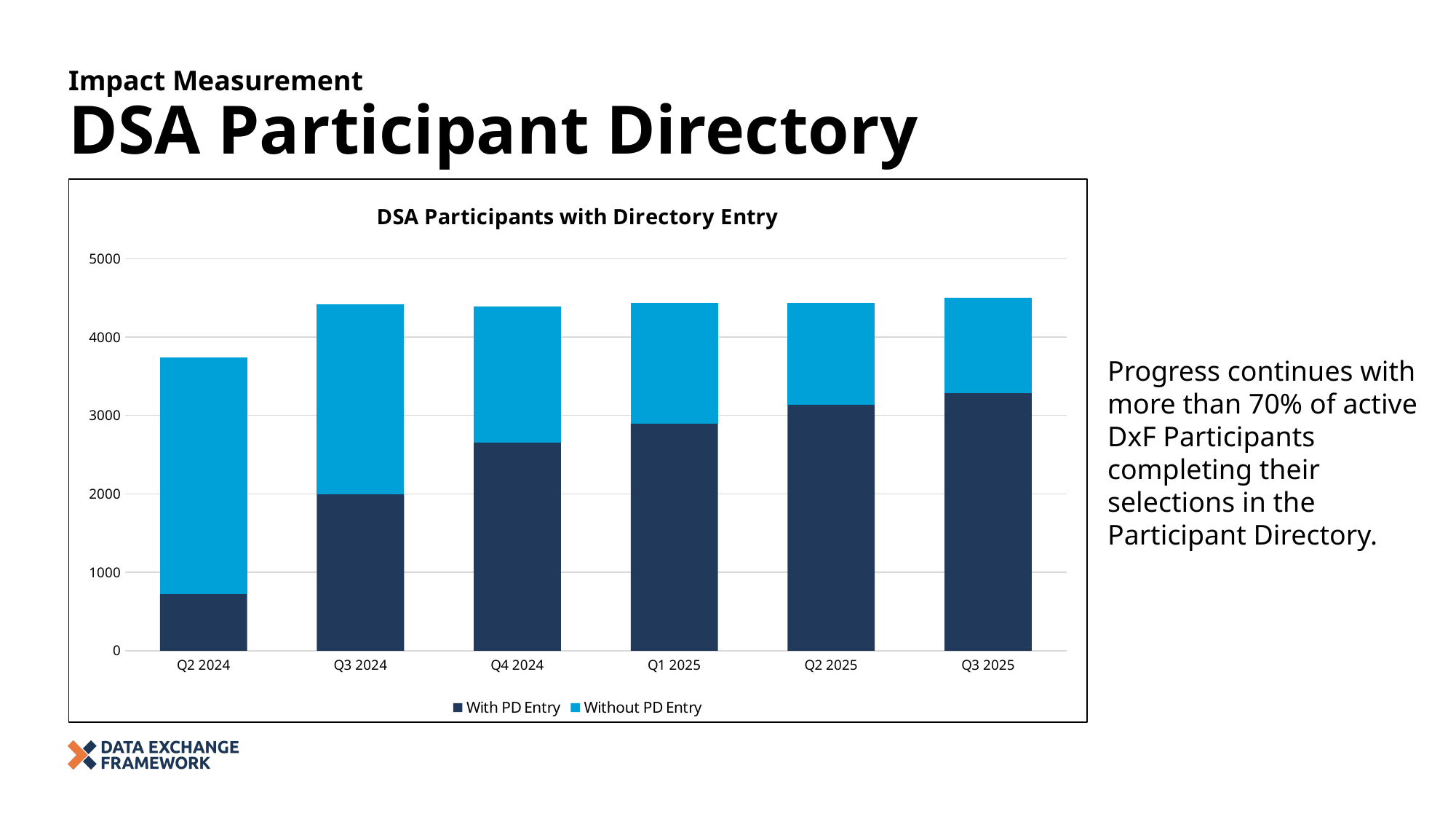
Which quarter has the lowest total bar height? Q2 2024 In Q2 2024, which is larger: the With PD Entry segment or the Without PD Entry segment? Without PD Entry What kind of chart is shown on the slide? Stacked bar chart Which quarter has the lowest With PD Entry value? Q2 2024 Is the With PD Entry value for Q3 2025 greater or less than 3000? greater How many quarters are shown on the x axis of the chart? 6 What is the title of the chart? DSA Participants with Directory Entry Is the With PD Entry value for Q2 2024 greater or less than 1000? less How many series does the chart's legend list? 2 Does the With PD Entry value rise or fall from Q2 2024 to Q3 2025? Rises Which quarter has the highest With PD Entry value? Q3 2025 Is the total bar height for Q3 2024 greater or less than 4000? greater